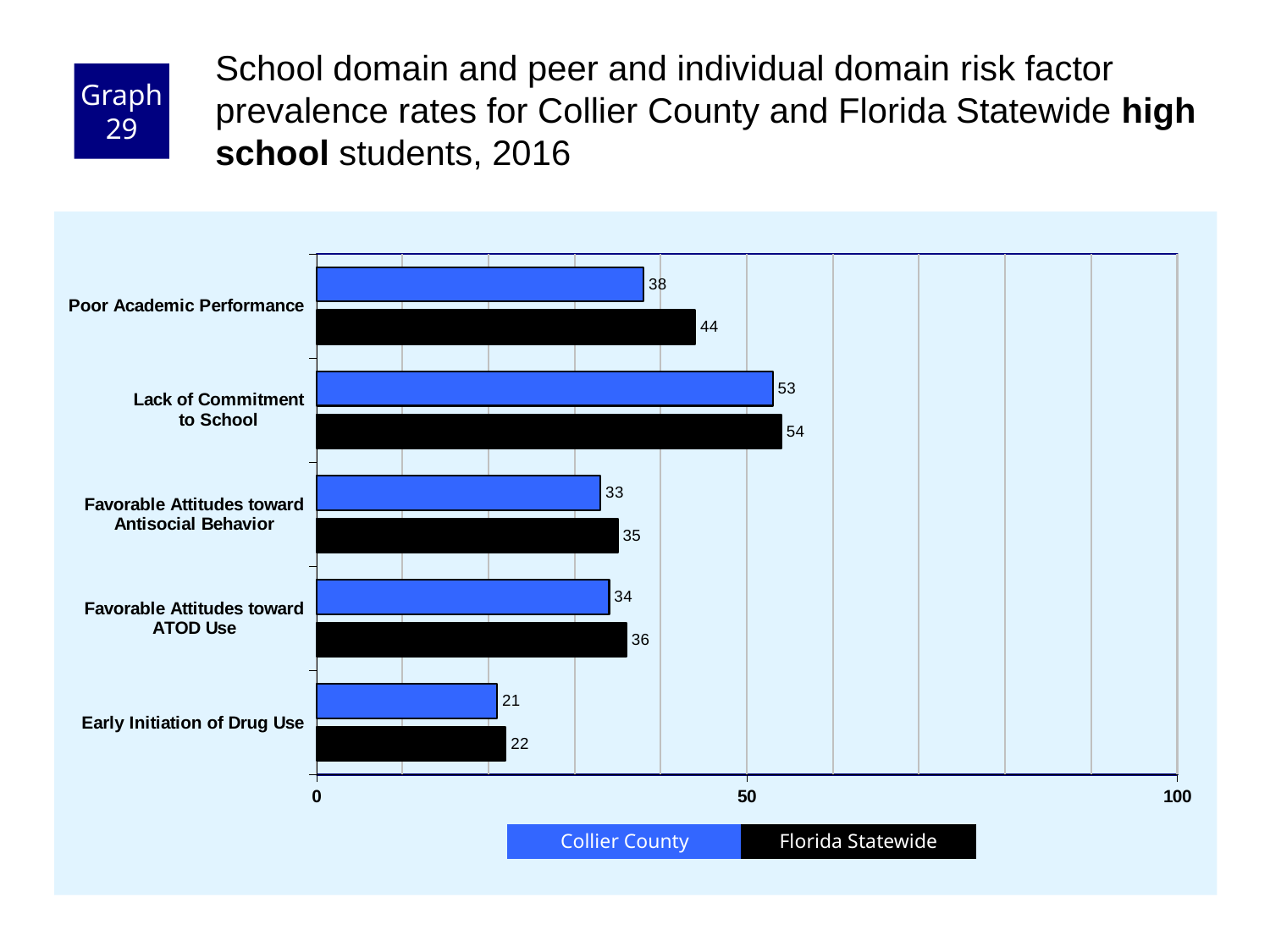
Which is larger for Favorable Attitudes toward ATOD Use: the Collier County value or the Florida Statewide value? Florida Statewide What is the Collier County value for Poor Academic Performance? 38 What kind of chart is shown on the slide? bar chart Is the Florida Statewide value for Lack of Commitment to School greater or less than 50? greater Which risk factor has the lowest Florida Statewide value? Early Initiation of Drug Use What is the Collier County value for Early Initiation of Drug Use? 21 Which colour represents Florida Statewide in the chart? black What is the difference between the Florida Statewide and Collier County values for Poor Academic Performance? 6 How many risk factor categories are shown on the chart? 5 What is the Florida Statewide value for Lack of Commitment to School? 54 How many series does the legend list? 2 Which risk factor has the highest Collier County value? Lack of Commitment to School